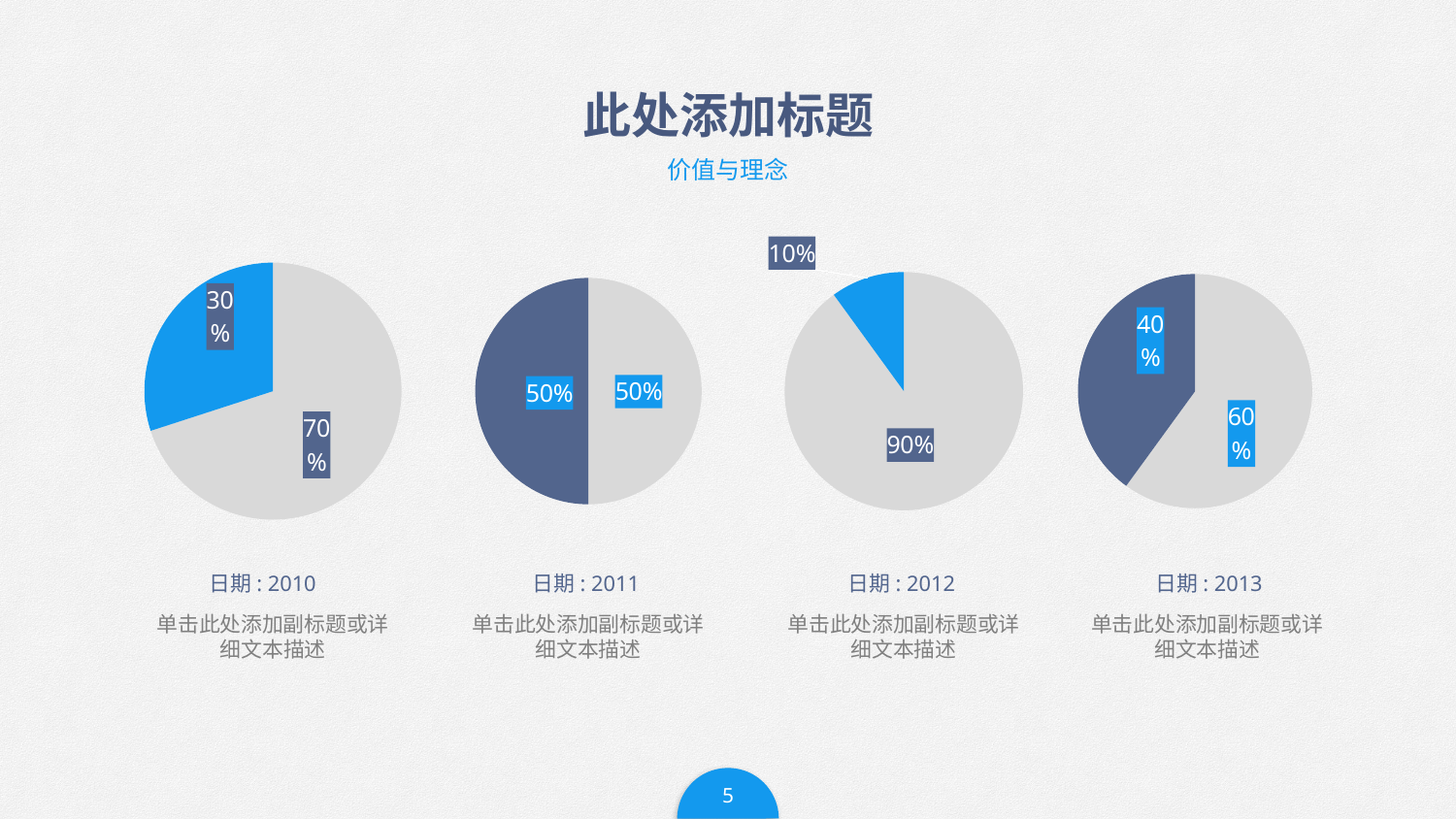
What kind of chart is used for each of the four dated figures on the slide? pie chart In the pie chart labelled 日期：2012, what share does the grey slice have? 90% How many pie charts are shown on the slide? 4 In the pie chart labelled 日期：2011, what share does the dark blue slice have? 50% In the pie chart labelled 日期：2013, what share does the grey slice have? 60% What is the difference between the two slices in the pie chart labelled 日期：2010? 40% How many slices does each pie chart on the slide have? 2 In the pie chart labelled 日期：2012, which slice is larger, the light blue one or the grey one? the grey one